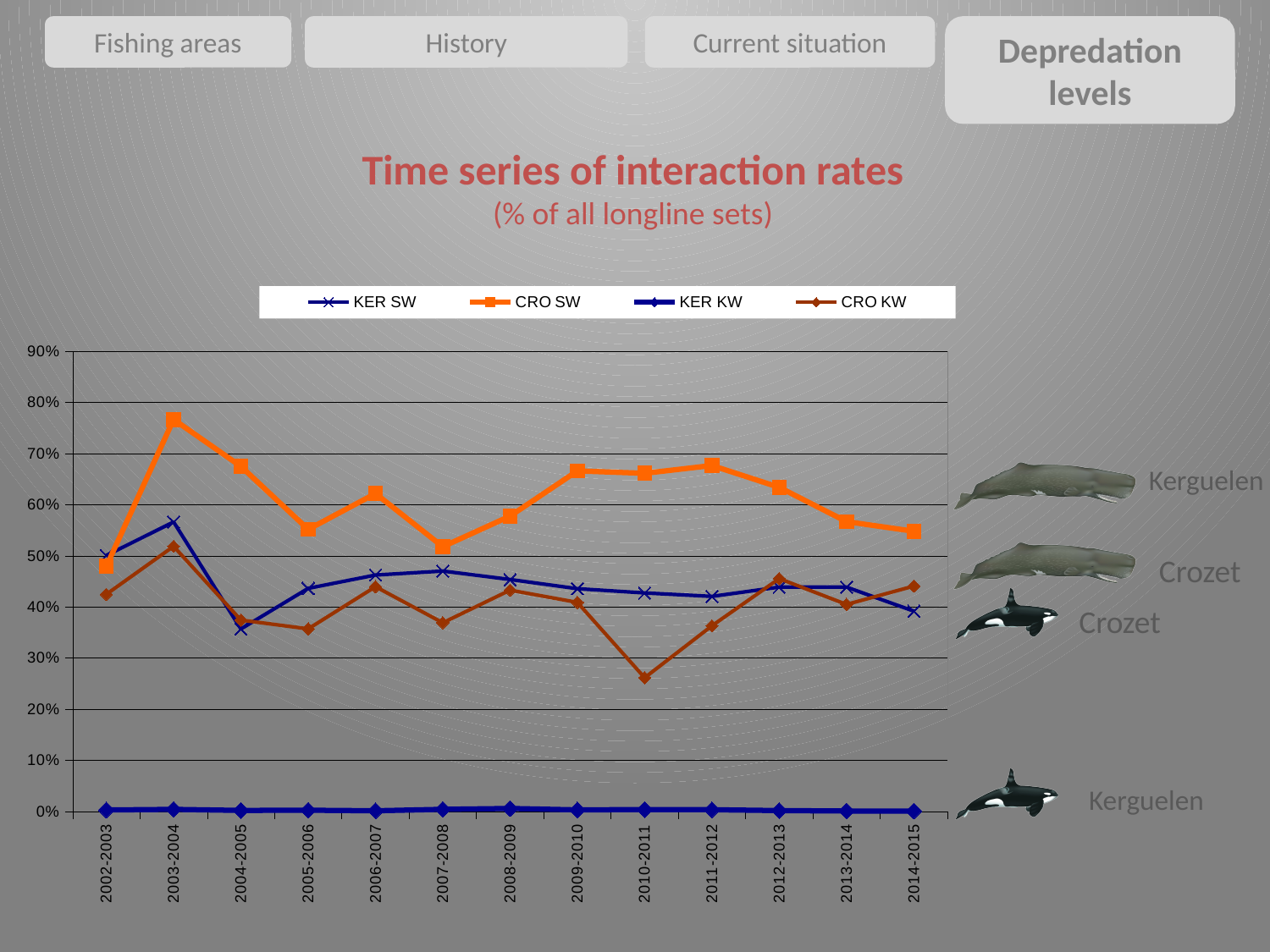
Is the CRO SW value for 2003-2004 greater or less than 70%? greater What kind of chart is shown on the slide? line chart Is the CRO KW value for 2010-2011 greater or less than 30%? less Is the KER SW value for 2004-2005 greater or less than 40%? less In which season does the CRO KW series reach its lowest value? 2010-2011 Which series stays lowest across all seasons, close to 0%? KER KW How many series does the legend list? 4 What is the title of the chart? Time series of interaction rates In 2014-2015, which is larger: CRO SW or KER SW? CRO SW In which season does the CRO SW series reach its highest value? 2003-2004 How many fishing seasons are plotted along the x axis? 13